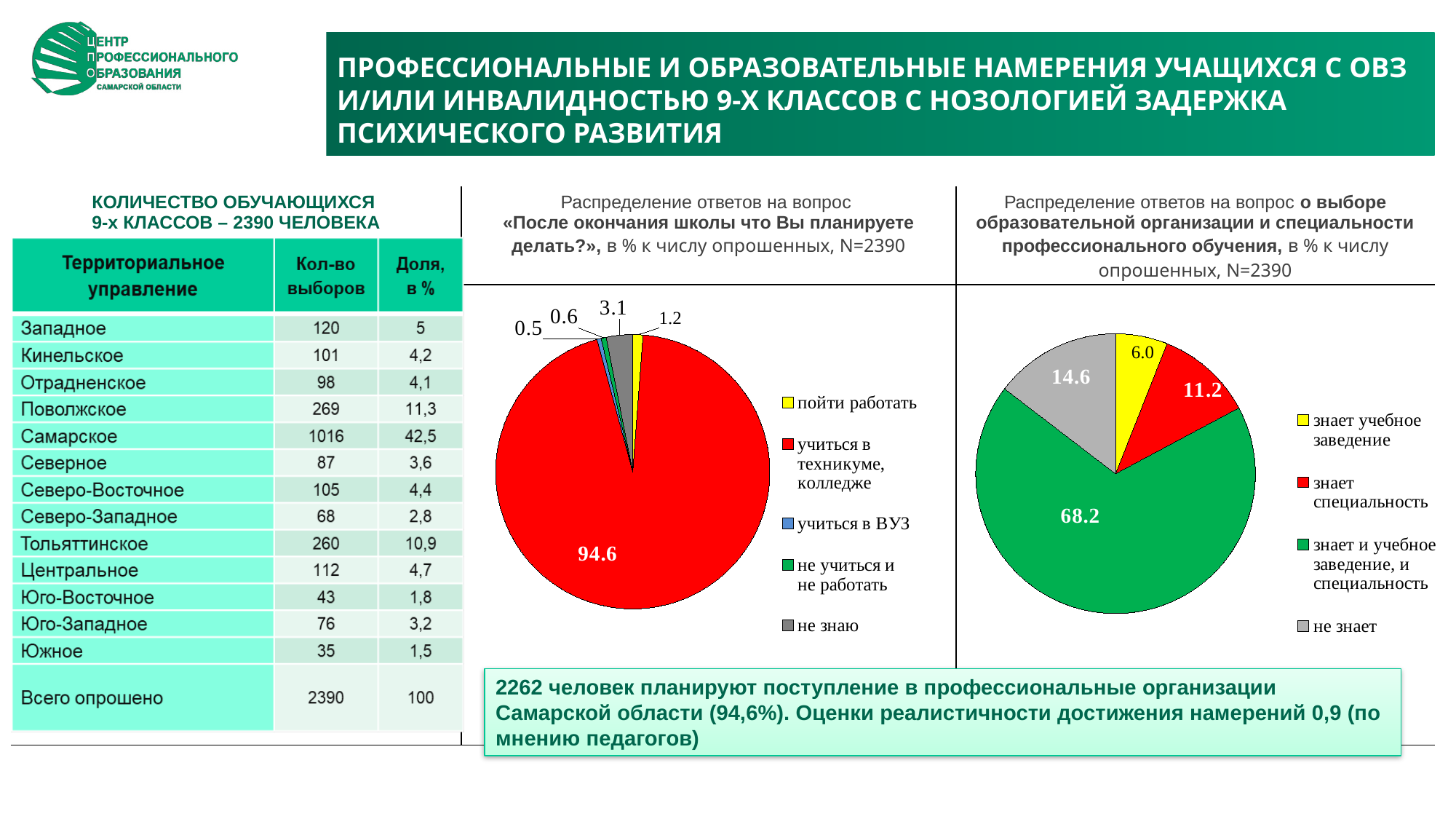
In the middle pie chart ("После окончания школы что Вы планируете делать?"), how many categories does the legend list? 5 What type of chart is used for the two charts on the right side of the slide? Pie chart In the right pie chart (о выборе образовательной организации и специальности), which is larger: "знает специальность" or "не знает"? не знает In the middle pie chart ("После окончания школы что Вы планируете делать?"), what is the value for "не знаю"? 3.1 In the right pie chart (о выборе образовательной организации и специальности), which category has the smallest slice? знает учебное заведение In the middle pie chart ("После окончания школы что Вы планируете делать?"), which category has the smallest slice? учиться в ВУЗ In the middle pie chart ("После окончания школы что Вы планируете делать?"), what is the value for "учиться в техникуме, колледже"? 94.6 In the middle pie chart ("После окончания школы что Вы планируете делать?"), what is the value for "пойти работать"? 1.2 In the right pie chart (о выборе образовательной организации и специальности), what is the difference between "знает специальность" and "знает учебное заведение"? 5.2 In the right pie chart (о выборе образовательной организации и специальности), what is the value for "не знает"? 14.6 In the middle pie chart ("После окончания школы что Вы планируете делать?"), what is the difference between "не знаю" and "пойти работать"? 1.9 In the right pie chart (о выборе образовательной организации и специальности), what is the value for "знает и учебное заведение, и специальность"? 68.2